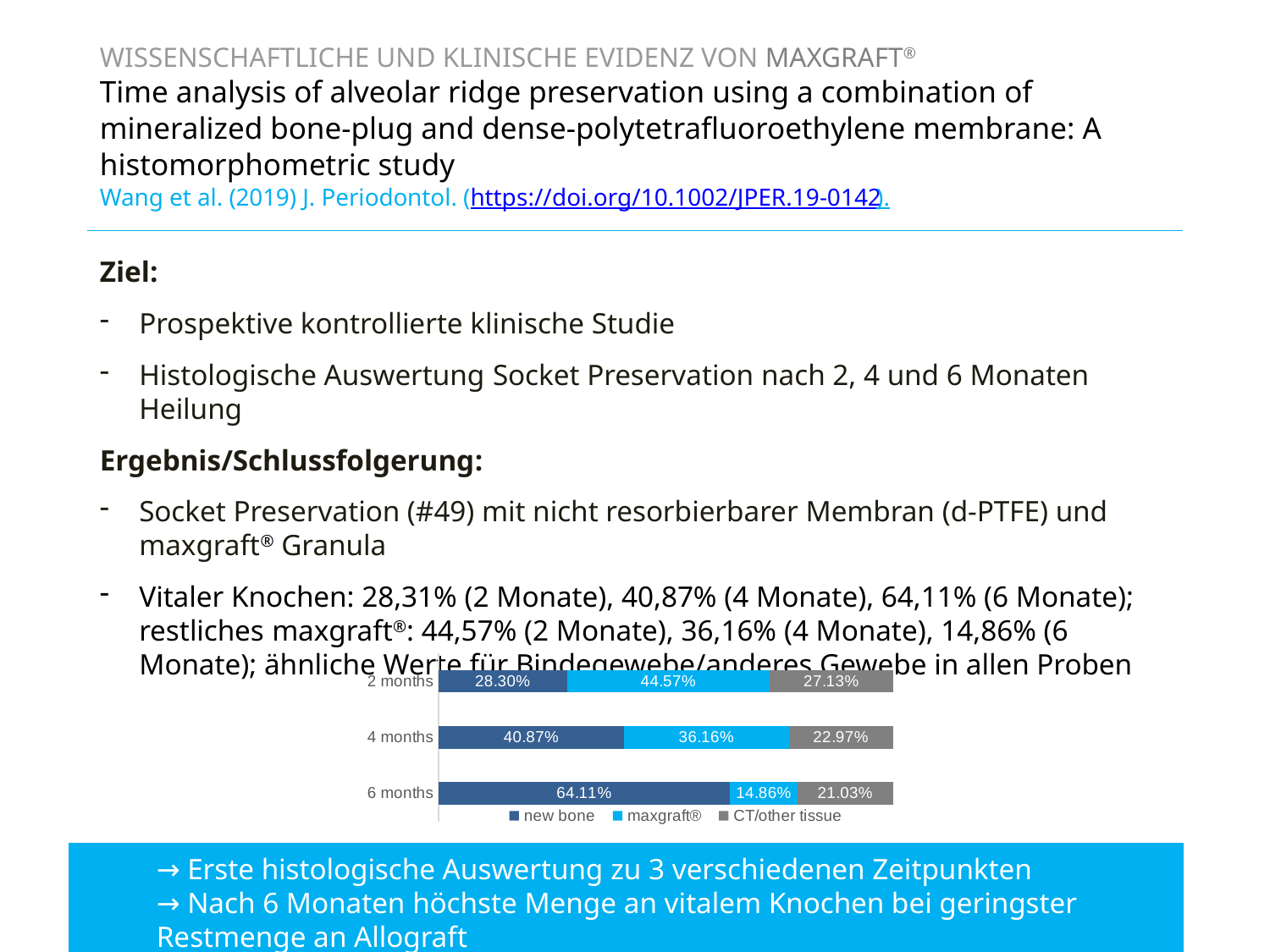
How many series does the chart legend list? 3 What is the difference between the new bone value at 6 months and at 2 months? 35.81 percentage points What is the value for new bone at 2 months? 28.30% What is the total of the stacked bar for 4 months? 100.00% At which time point is the maxgraft® value lowest? 6 months Does the new bone value rise or fall from 2 months to 6 months? Rise Which is larger at 2 months: new bone or maxgraft®? maxgraft® What is the value for maxgraft® at 4 months? 36.16% At which time point is the new bone value highest? 6 months What is the value for CT/other tissue at 6 months? 21.03% How many time points (categories) are plotted in the chart? 3 What kind of chart is shown on the slide? Stacked bar chart